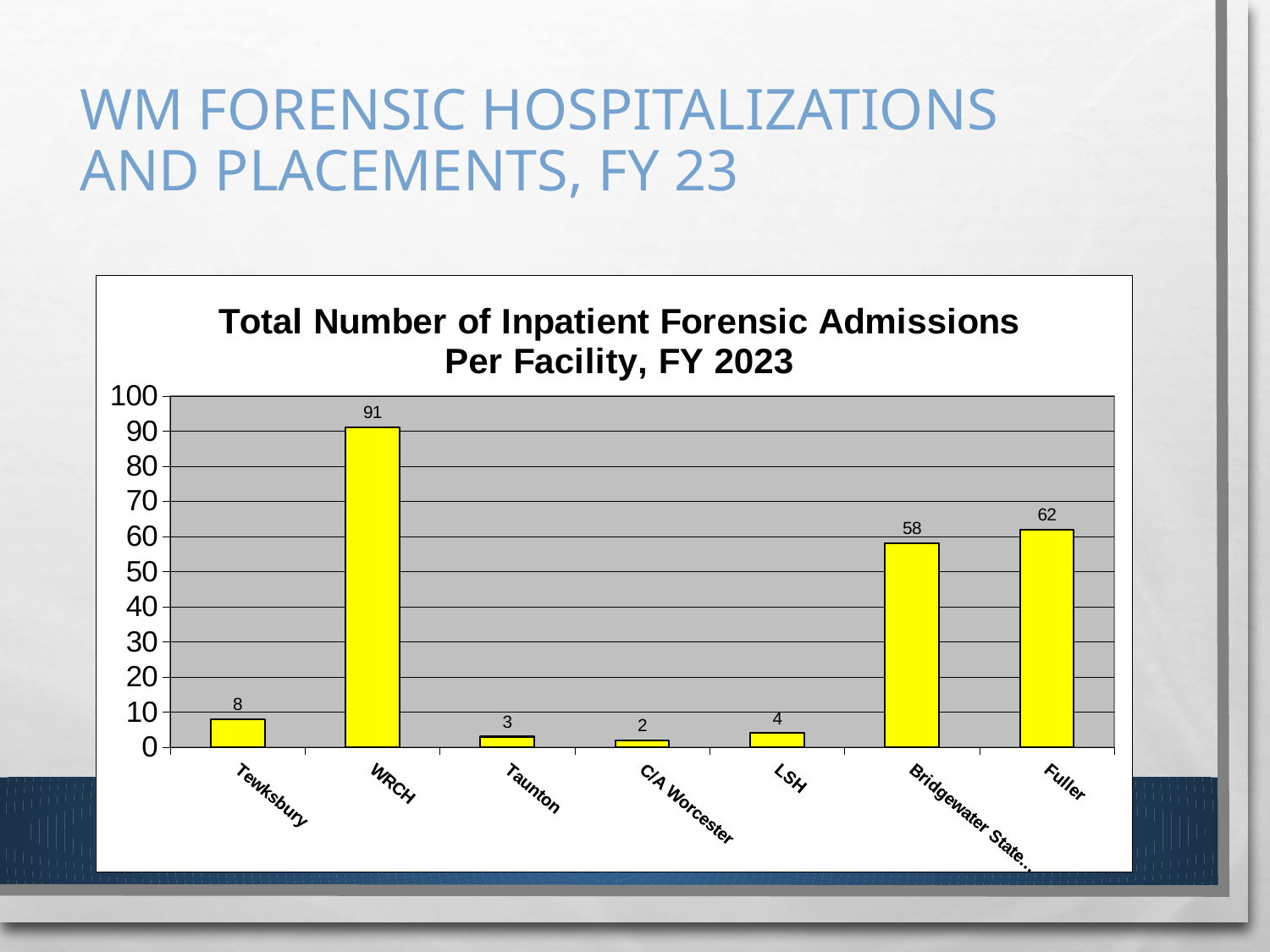
What is the value for WRCH? 91 Which is larger, the value for Taunton or the value for LSH? LSH What kind of chart is shown on the slide? Bar chart What is the difference between the values for Fuller and Bridgewater State? 4 Which facility has the highest number of inpatient forensic admissions? WRCH What is the value for Fuller? 62 What is the difference between the values for WRCH and Fuller? 29 How many facilities are shown on the chart? 7 What is the value for Tewksbury? 8 What is the value for LSH? 4 Is the value for Bridgewater State greater or less than 50? greater Which facility has the lowest number of inpatient forensic admissions? C/A Worcester